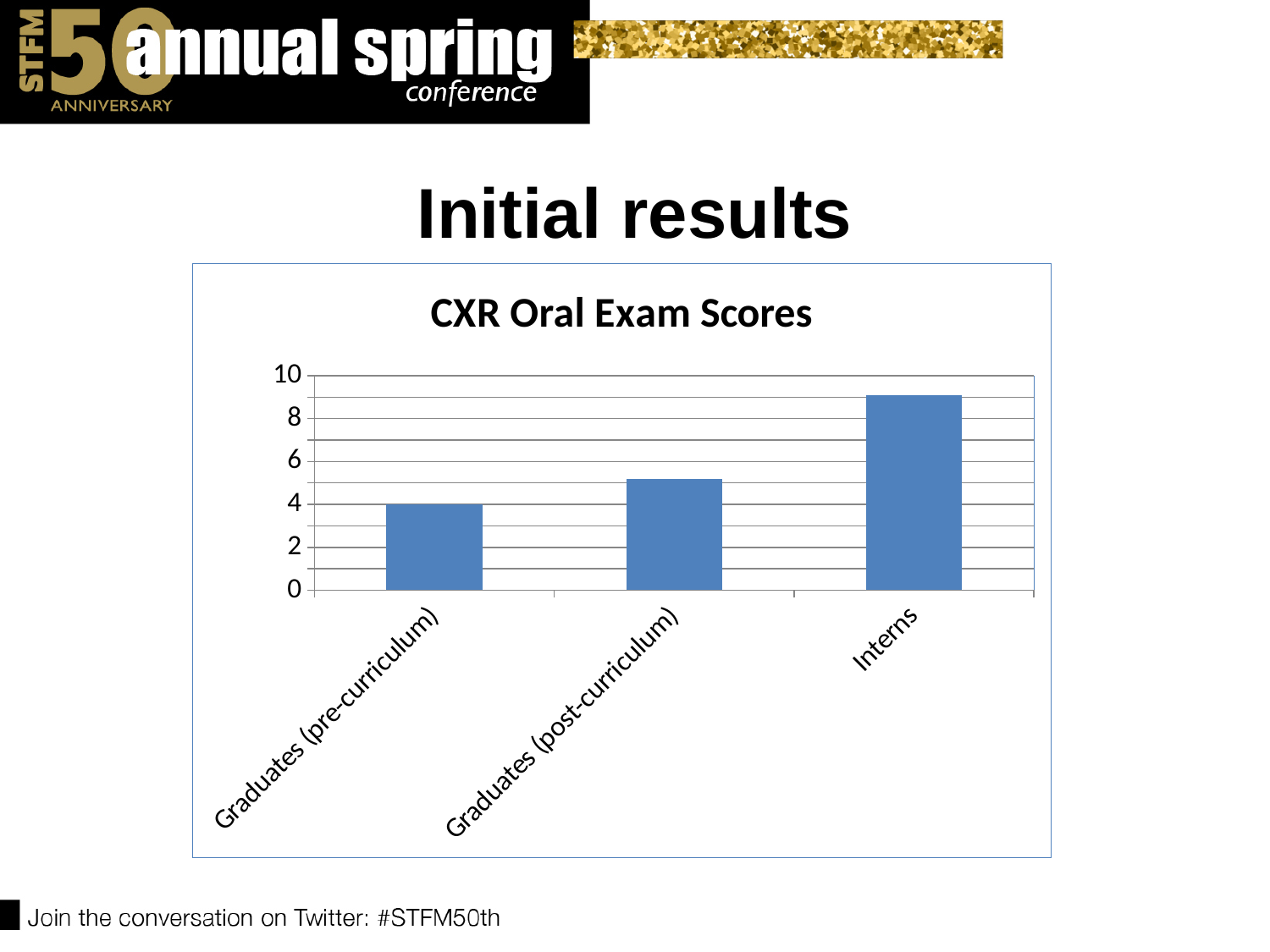
Which is larger, the score for Graduates (post-curriculum) or for Interns? Interns Is the value for Interns greater or less than 8? greater How many categories are plotted in the chart? 3 What is the title of the chart? CXR Oral Exam Scores Which category has the lowest score? Graduates (pre-curriculum) Which is larger, the score for Graduates (pre-curriculum) or for Graduates (post-curriculum)? Graduates (post-curriculum) Is the value for Graduates (post-curriculum) greater or less than 6? less Is the value for Graduates (post-curriculum) greater or less than 4? greater What kind of chart is shown on the slide? bar chart Which category has the highest score? Interns Do the values rise or fall from left to right across the categories? rise